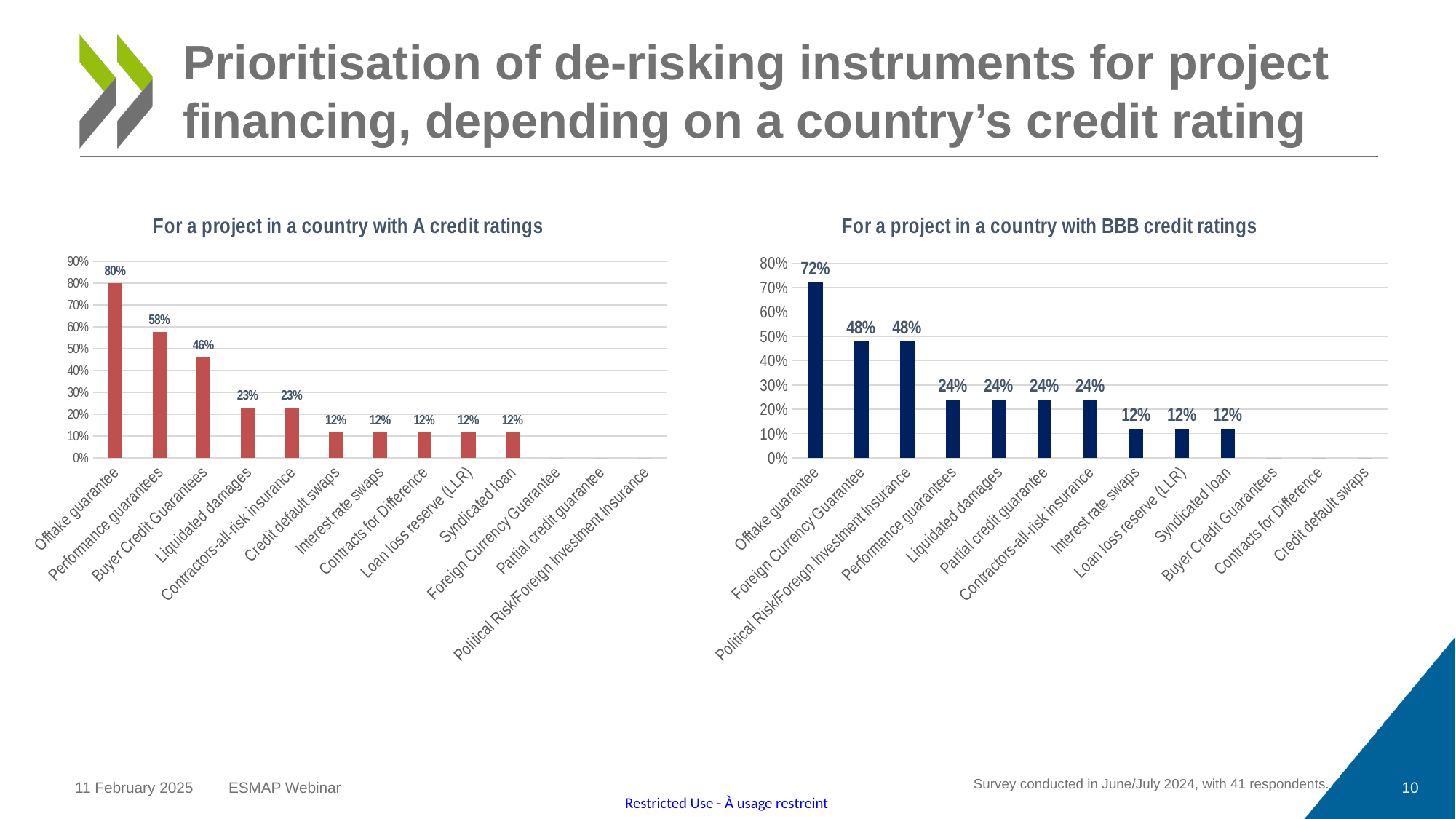
In the chart 'For a project in a country with BBB credit ratings', what is the difference between Offtake guarantee and Political Risk/Foreign Investment Insurance? 24% In the chart 'For a project in a country with A credit ratings', which category has the highest value? Offtake guarantee In the chart 'For a project in a country with A credit ratings', what is the value for Offtake guarantee? 80% In the chart 'For a project in a country with A credit ratings', what is the value for Buyer Credit Guarantees? 46% In the chart 'For a project in a country with A credit ratings', which is larger: Performance guarantees or Liquidated damages? Performance guarantees In the chart 'For a project in a country with BBB credit ratings', which category has the highest value? Offtake guarantee In the chart 'For a project in a country with BBB credit ratings', which is larger: Interest rate swaps or Liquidated damages? Liquidated damages In the chart 'For a project in a country with A credit ratings', what is the difference between Offtake guarantee and Performance guarantees? 22% In the chart 'For a project in a country with BBB credit ratings', what is the value for Foreign Currency Guarantee? 48% In the chart 'For a project in a country with BBB credit ratings', what is the value for Partial credit guarantee? 24% What kind of chart is 'For a project in a country with A credit ratings'? Bar chart How many categories are listed on the x axis of the chart 'For a project in a country with BBB credit ratings'? 13